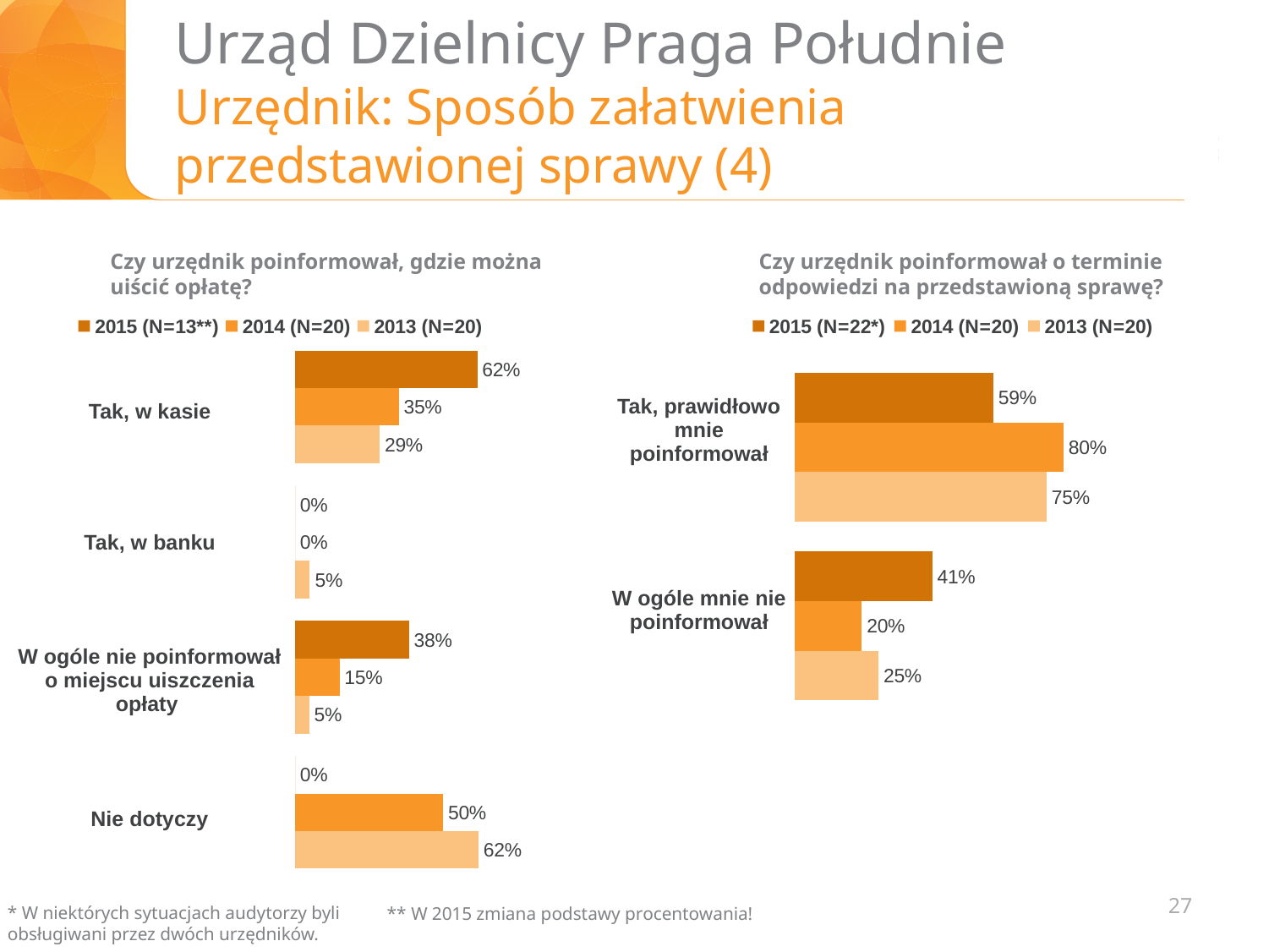
In the left chart, which category has the highest value for 2013? Nie dotyczy In the left chart, what is the value for "Nie dotyczy" in 2014? 50% In the left chart, how many categories are shown? 4 In the right chart, is the 2013 value for "W ogóle mnie nie poinformował" larger or smaller than the 2014 value? larger In the right chart ("Czy urzędnik poinformował o terminie odpowiedzi na przedstawioną sprawę?"), what is the value for "Tak, prawidłowo mnie poinformował" in 2014? 80% In the right chart, which year has the lowest value for "Tak, prawidłowo mnie poinformował"? 2015 In the right chart, what is the value for "W ogóle mnie nie poinformował" in 2015? 41% In the left chart, what is the difference between the 2015 and 2014 values for "Tak, w kasie"? 27 percentage points How many series does the legend of the right chart list? 3 In the left chart ("Czy urzędnik poinformował, gdzie można uiścić opłatę?"), what is the value for "Tak, w kasie" in 2015? 62% What type of chart is the left chart? bar chart In the left chart, what is the value for "Tak, w banku" in 2013? 5%